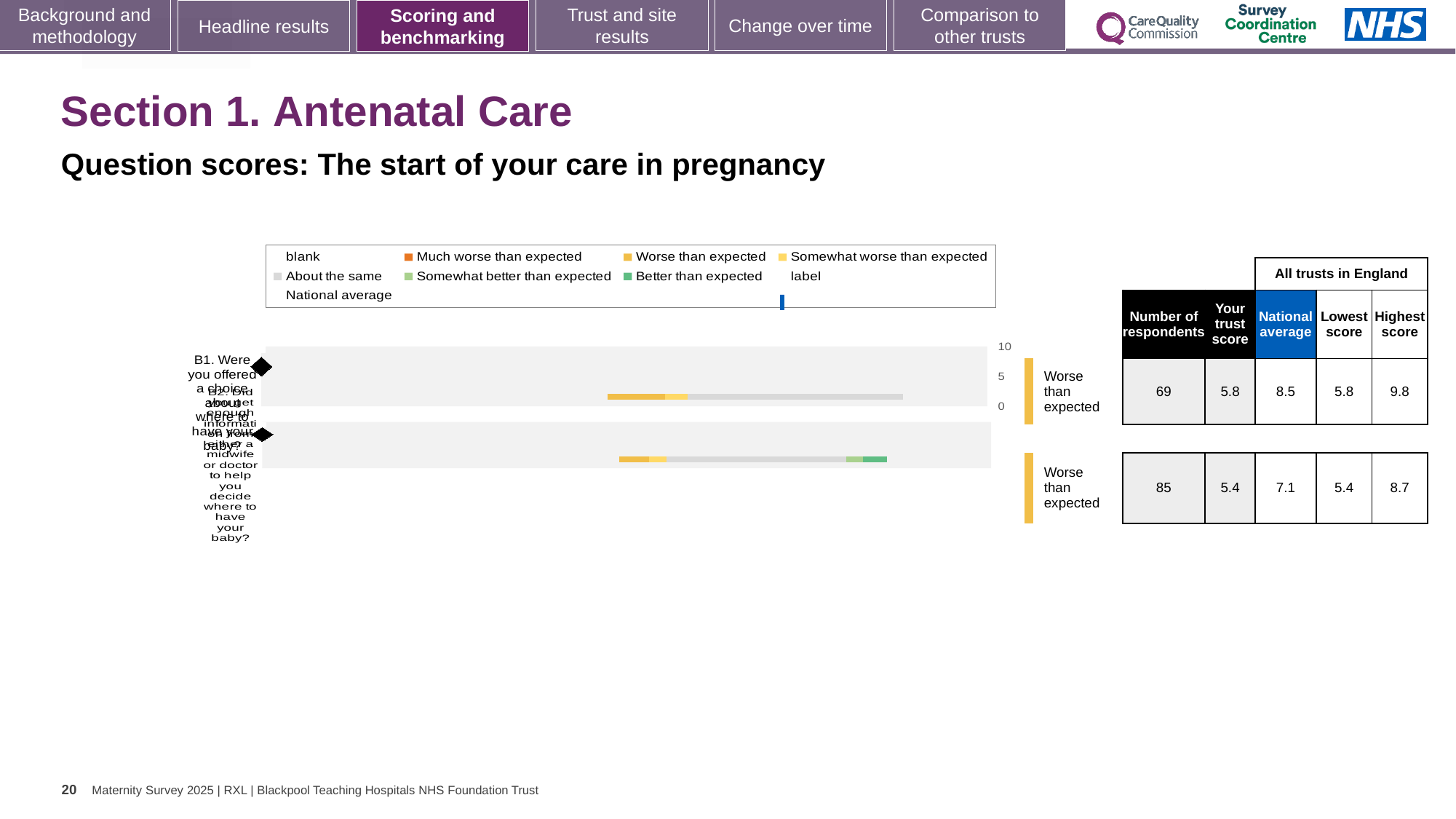
Which question has the larger number of respondents? B2 What benchmark rating is shown next to the bar for question B1? Worse than expected What benchmark rating is shown next to the bar for question B2? Worse than expected How many questions (bars) are plotted in the chart? 2 What kind of chart is shown on the slide? bar chart How many entries does the chart legend list? 9 In the table beside the chart, what is the highest score for question B2? 8.7 In the table beside the chart, what is the trust score for question B1? 5.8 In the table beside the chart, what is the number of respondents for question B1? 69 Which question has the higher trust score, B1 or B2? B1 By how much does the national average exceed the trust score for question B1? 2.7 In the table beside the chart, what is the national average for question B2? 7.1